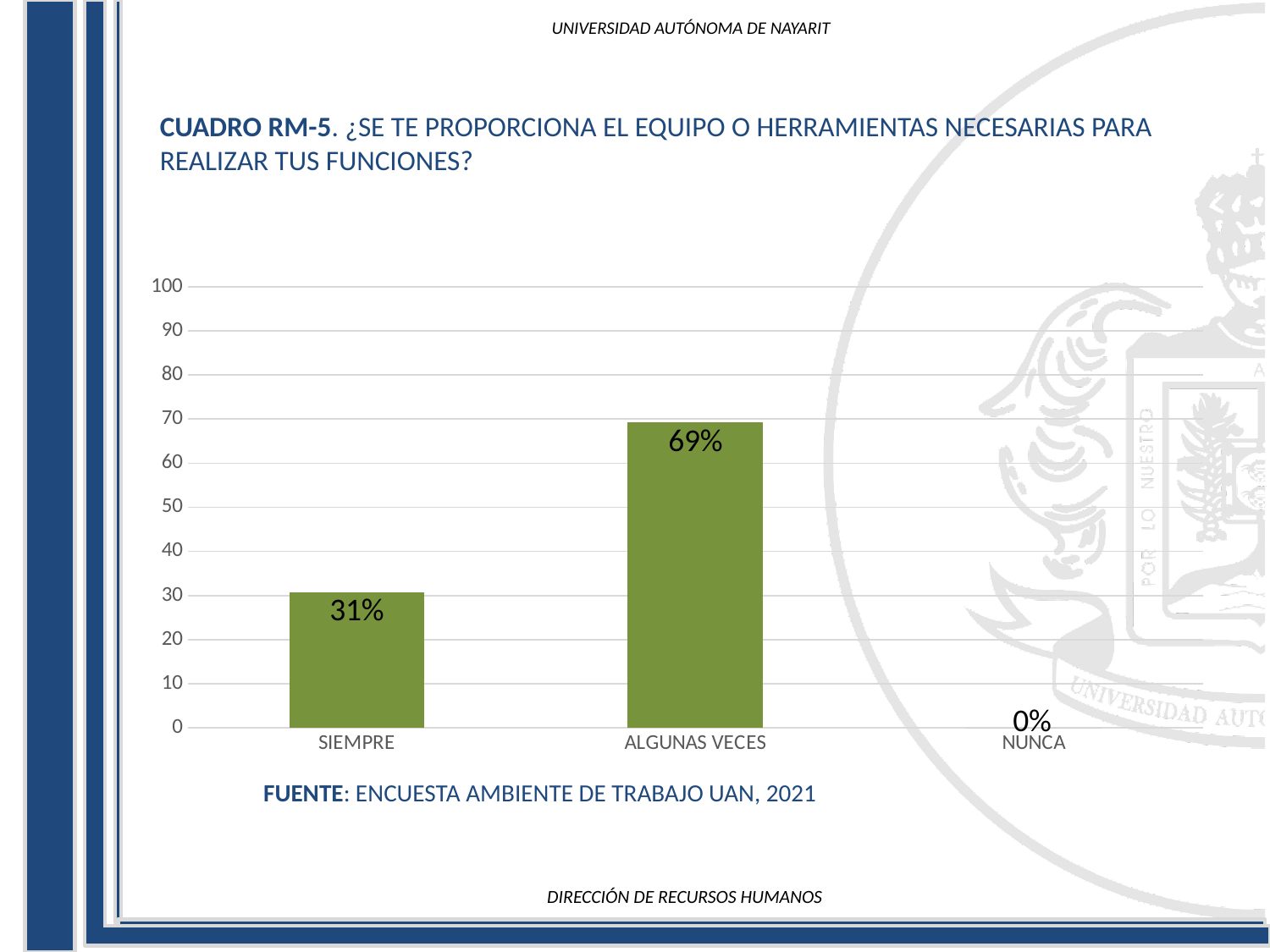
What is the value for SIEMPRE? 31% Which category has the lowest value? NUNCA Is the value for SIEMPRE greater or less than 40? less Which is larger, the value for SIEMPRE or the value for ALGUNAS VECES? ALGUNAS VECES What is the value for NUNCA? 0% What is the difference between the values for ALGUNAS VECES and SIEMPRE? 38% What kind of chart is shown on the slide? bar chart How many categories are shown on the x axis? 3 What source is cited below the chart? ENCUESTA AMBIENTE DE TRABAJO UAN, 2021 What is the value for ALGUNAS VECES? 69% Which category has the highest value? ALGUNAS VECES Is the value for ALGUNAS VECES greater or less than 50? greater